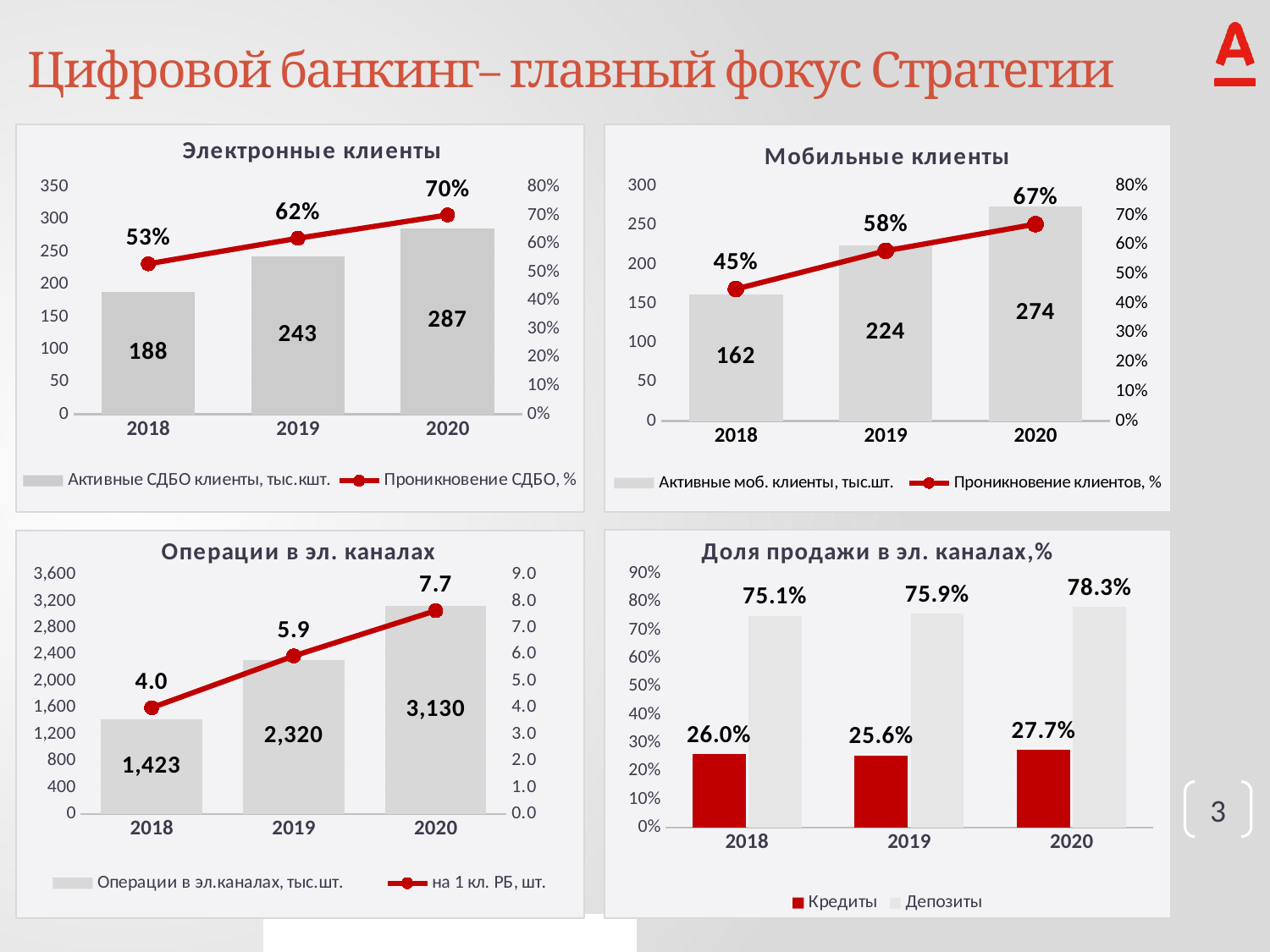
In the 'Электронные клиенты' chart, what is the SDBO penetration (%) for 2020? 70% In the 'Операции в эл. каналах' chart, what is the value of operations in electronic channels (тыс.шт.) for 2020? 3,130 In the 'Операции в эл. каналах' chart, what is the value of 'на 1 кл. РБ, шт.' for 2019? 5.9 In the 'Мобильные клиенты' chart, what is the difference in active mobile clients between 2020 and 2018? 112 In the 'Электронные клиенты' chart, what is the value of active SDBO clients (тыс.шт.) for 2019? 243 In the 'Операции в эл. каналах' chart, do operations in electronic channels rise or fall from 2018 to 2020? rise In the 'Доля продажи в эл. каналах,%' chart, what is the share for Депозиты in 2020? 78.3% In the 'Доля продажи в эл. каналах,%' chart, how many series does the legend list? 2 In the 'Мобильные клиенты' chart, which year has the highest number of active mobile clients? 2020 In the 'Электронные клиенты' chart, which is larger: the active SDBO clients value for 2018 or for 2019? 2019 In the 'Мобильные клиенты' chart, what is the value of active mobile clients for 2018? 162 In the 'Доля продажи в эл. каналах,%' chart, which year has the lowest share for Кредиты? 2019